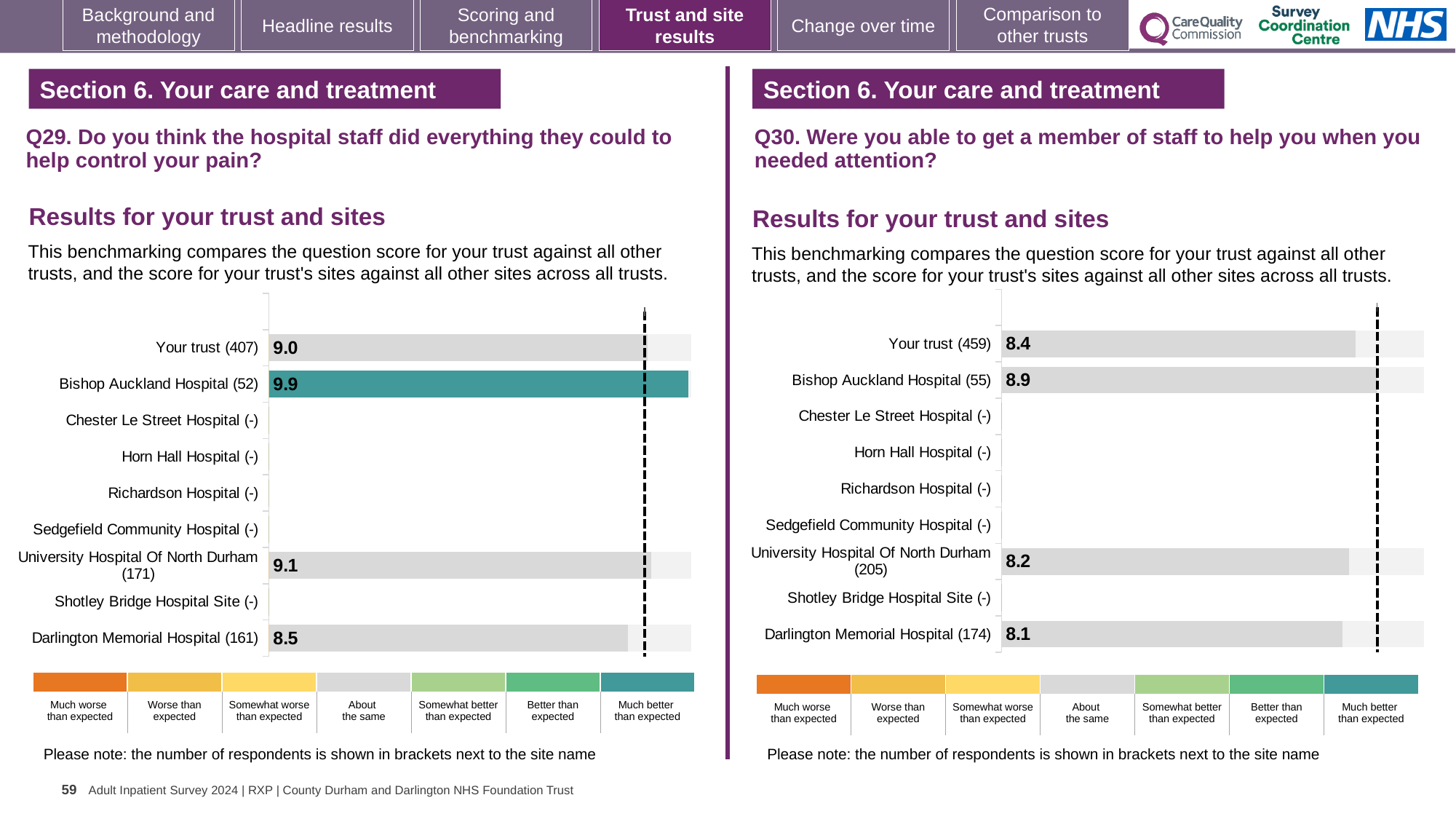
In the Q29 chart on the left, how many respondents are shown in brackets for University Hospital Of North Durham? 171 In the Q30 chart on the right, what is the score for University Hospital Of North Durham? 8.2 In the Q29 chart on the left, which site has the highest score? Bishop Auckland Hospital In the Q30 chart on the right, which site with a score shown has the lowest score? Darlington Memorial Hospital In the Q30 chart on the right, what is the difference between the scores for Bishop Auckland Hospital and Your trust? 0.5 What kind of chart is used on the left for Q29? Bar chart In the Q29 chart on the left, what is the difference between the scores for Bishop Auckland Hospital and Darlington Memorial Hospital? 1.4 In the Q29 chart on the left, what is the score for Bishop Auckland Hospital? 9.9 In the Q29 chart on the left, which site's bar is coloured teal, indicating 'Much better than expected'? Bishop Auckland Hospital In the Q29 chart on the left, what is the score for Darlington Memorial Hospital? 8.5 In the Q30 chart on the right, what is the score for Your trust? 8.4 In the Q30 chart on the right, which is larger: the score for Bishop Auckland Hospital or the score for Darlington Memorial Hospital? Bishop Auckland Hospital